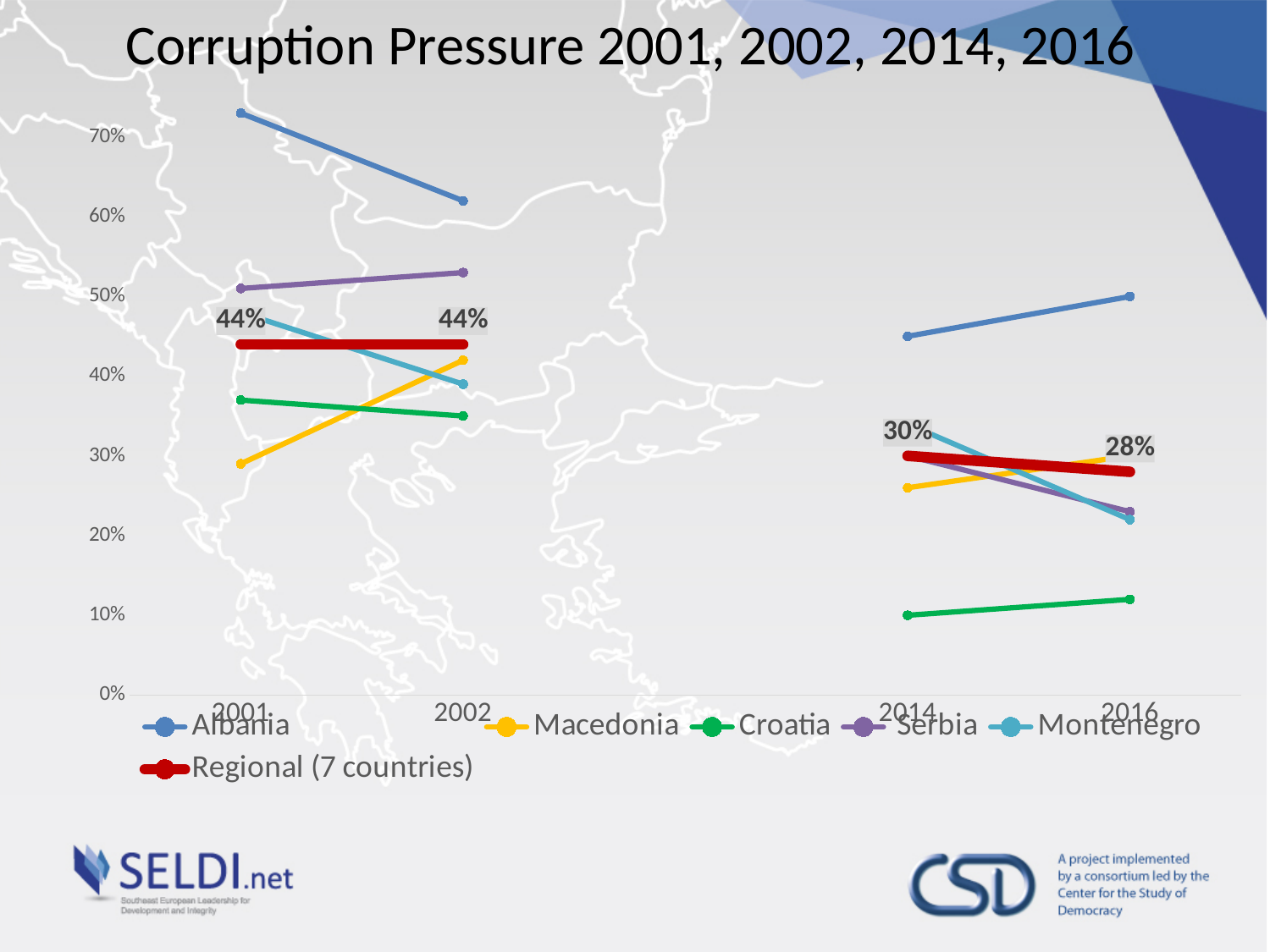
What is the value of the Regional (7 countries) series in 2014? 30% How many series does the legend list? 6 By how many percentage points did the Regional (7 countries) value change between 2014 and 2016? 2 percentage points What is the value of the Regional (7 countries) series in 2016? 28% Which country has the lowest value in 2016? Croatia What kind of chart is shown on the slide? line chart Which country has the highest value in 2001? Albania Does the Albania line rise or fall from 2001 to 2002? fall Is the value for Montenegro in 2016 greater or less than 30%? less Is the value for Albania in 2001 greater or less than 70%? greater Which is larger in 2016, the value for Albania or the value for Croatia? Albania What is the value of the Regional (7 countries) series in 2001? 44%